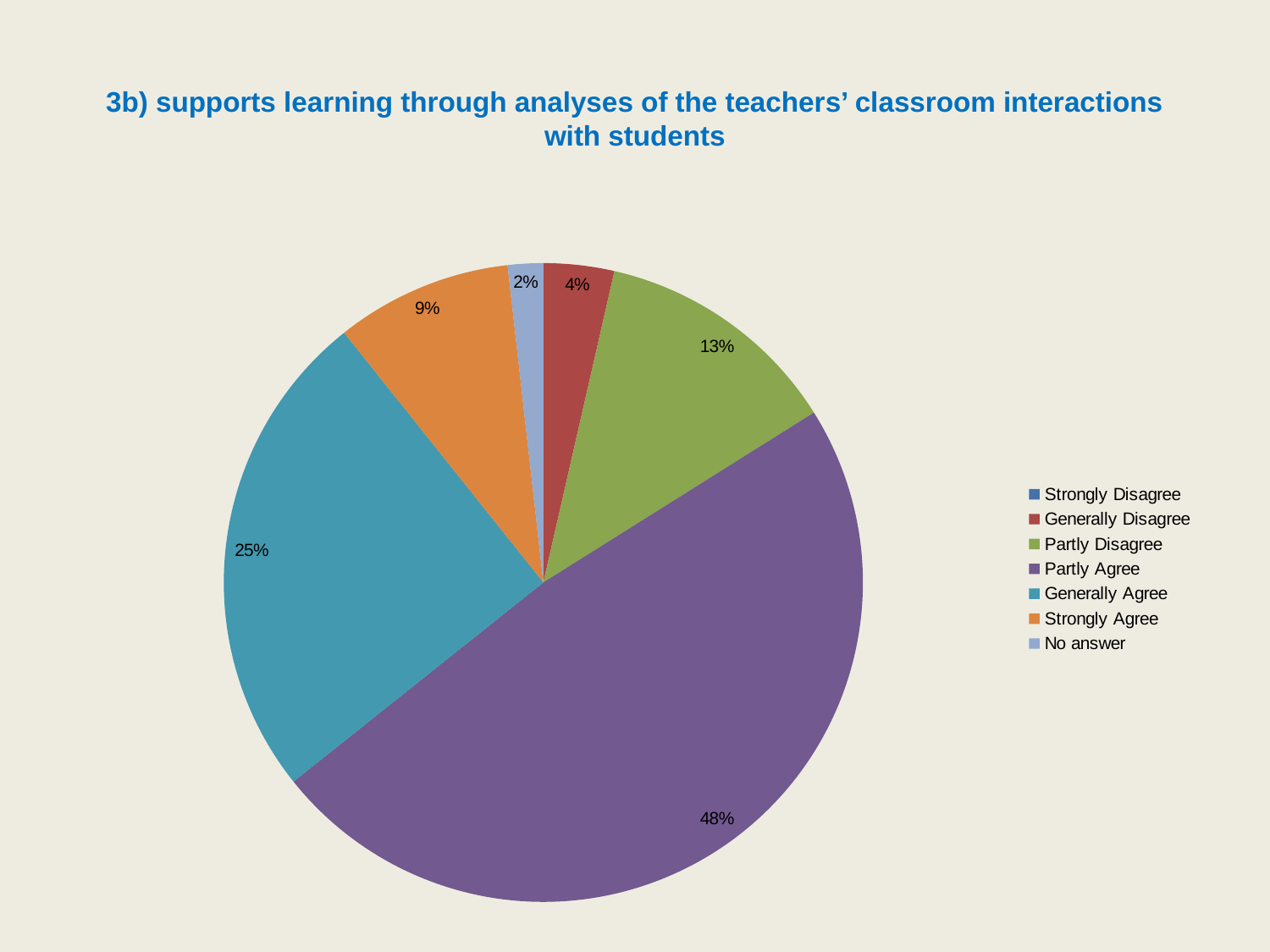
What share of the pie does Generally Agree have? 25% Which category has the largest slice of the pie? Partly Agree What share of the pie does Partly Agree have? 48% Which is larger, the Partly Disagree slice or the Strongly Agree slice? Partly Disagree What share of the pie does Partly Disagree have? 13% What share of the pie does No answer have? 2% What kind of chart is shown on the slide? pie chart How many entries does the legend list? 7 Which of the labelled slices is the smallest? No answer What share of the pie does Generally Disagree have? 4% What share of the pie does Strongly Agree have? 9% What is the difference between the Partly Agree and Generally Agree shares? 23%